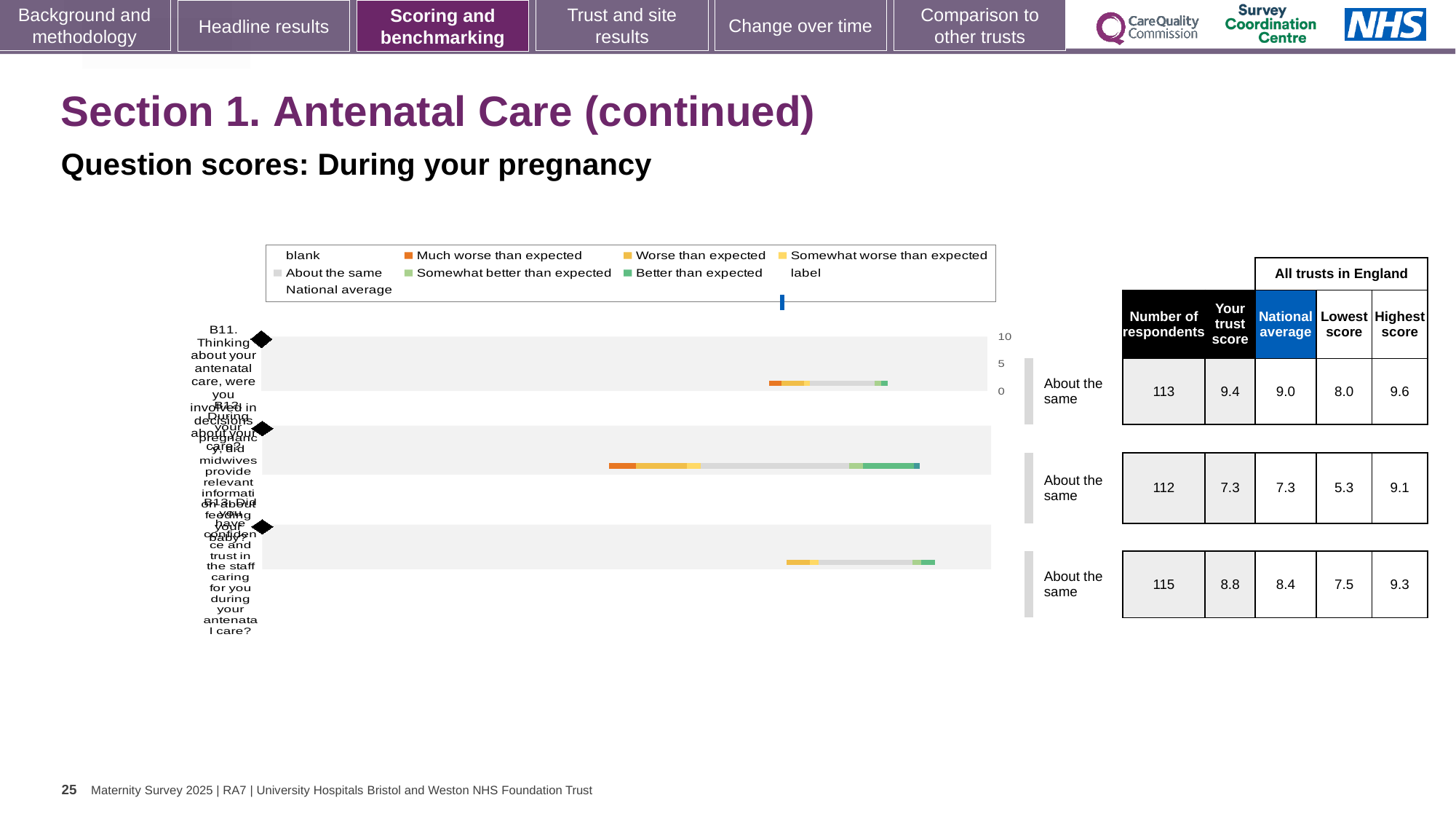
What colour represents 'Much worse than expected' in the chart legend? orange What kind of chart is shown on the slide? bar chart For question B11, which is larger: the trust score or the national average? the trust score (9.4) For question B13, what is the difference between the highest score and the lowest score in the table? 1.8 Which question has the highest 'Your trust score' in the table? B11 (9.4) In the table beside the chart, what is the national average for question B13? 8.4 How many question bars (categories) does the chart show? 3 What benchmark label is shown next to the bar for question B12? About the same What colour represents 'Better than expected' in the chart legend? green In the table beside the chart, how many respondents are listed for question B12? 112 In the table beside the chart, what is the 'Your trust score' for question B11? 9.4 How many entries does the chart legend list? 9